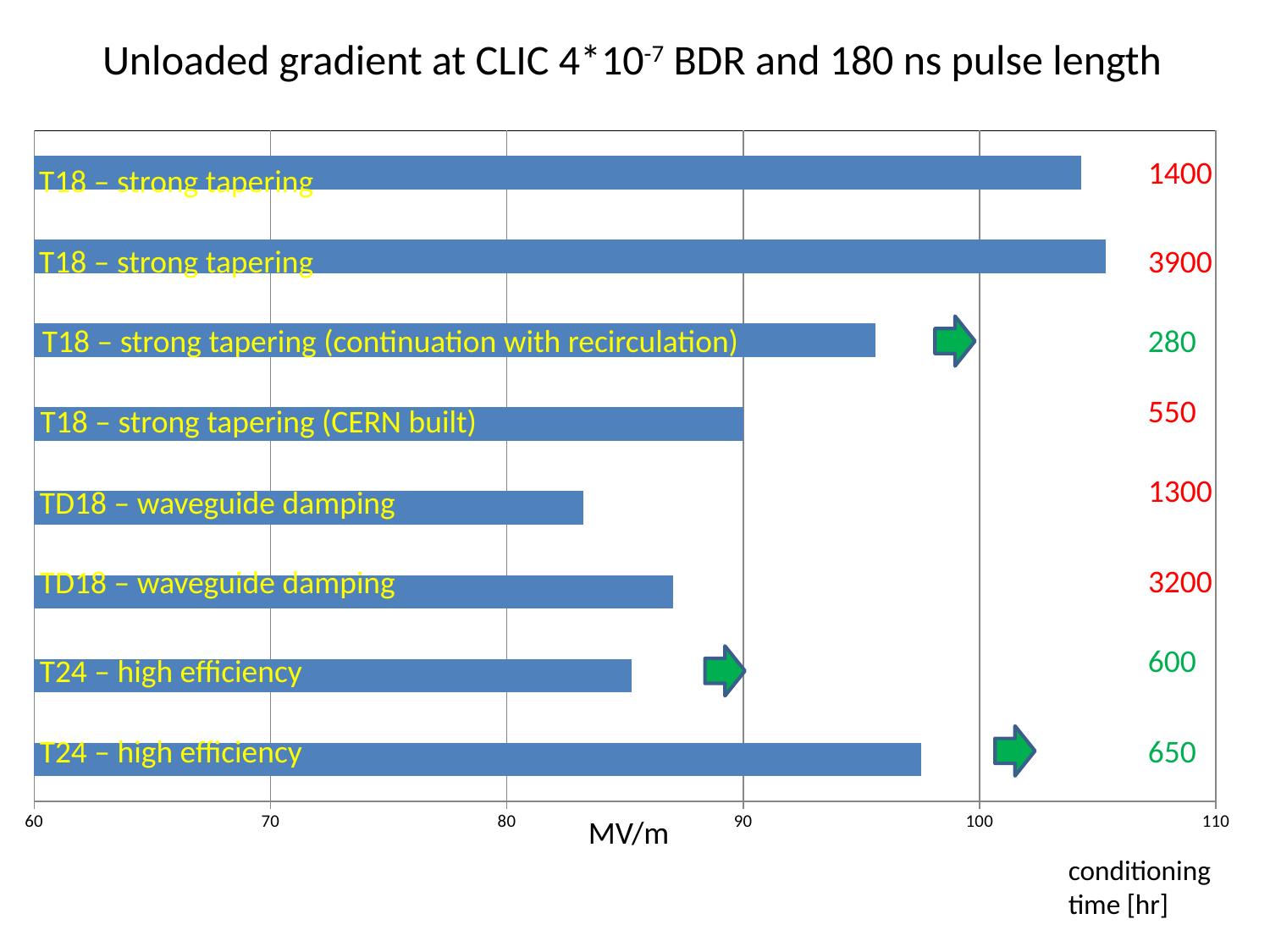
Are both bars labelled "T24 – high efficiency" greater or less than 80 MV/m? greater What unit is shown on the x axis of the chart? MV/m Is the value for "T18 – strong tapering (continuation with recirculation)" greater or less than 90 MV/m? greater How many bars are plotted in the chart? 8 Is the value for "T18 – strong tapering (continuation with recirculation)" greater or less than 100 MV/m? less What is the conditioning time in hours listed next to the "T18 – strong tapering (CERN built)" bar? 550 Which label does the shortest bar in the chart belong to? TD18 – waveguide damping What kind of chart is shown on the slide? bar chart Which is larger, the value for "T18 – strong tapering (continuation with recirculation)" or for "T18 – strong tapering (CERN built)"? T18 – strong tapering (continuation with recirculation) Which label do the two longest bars in the chart belong to? T18 – strong tapering